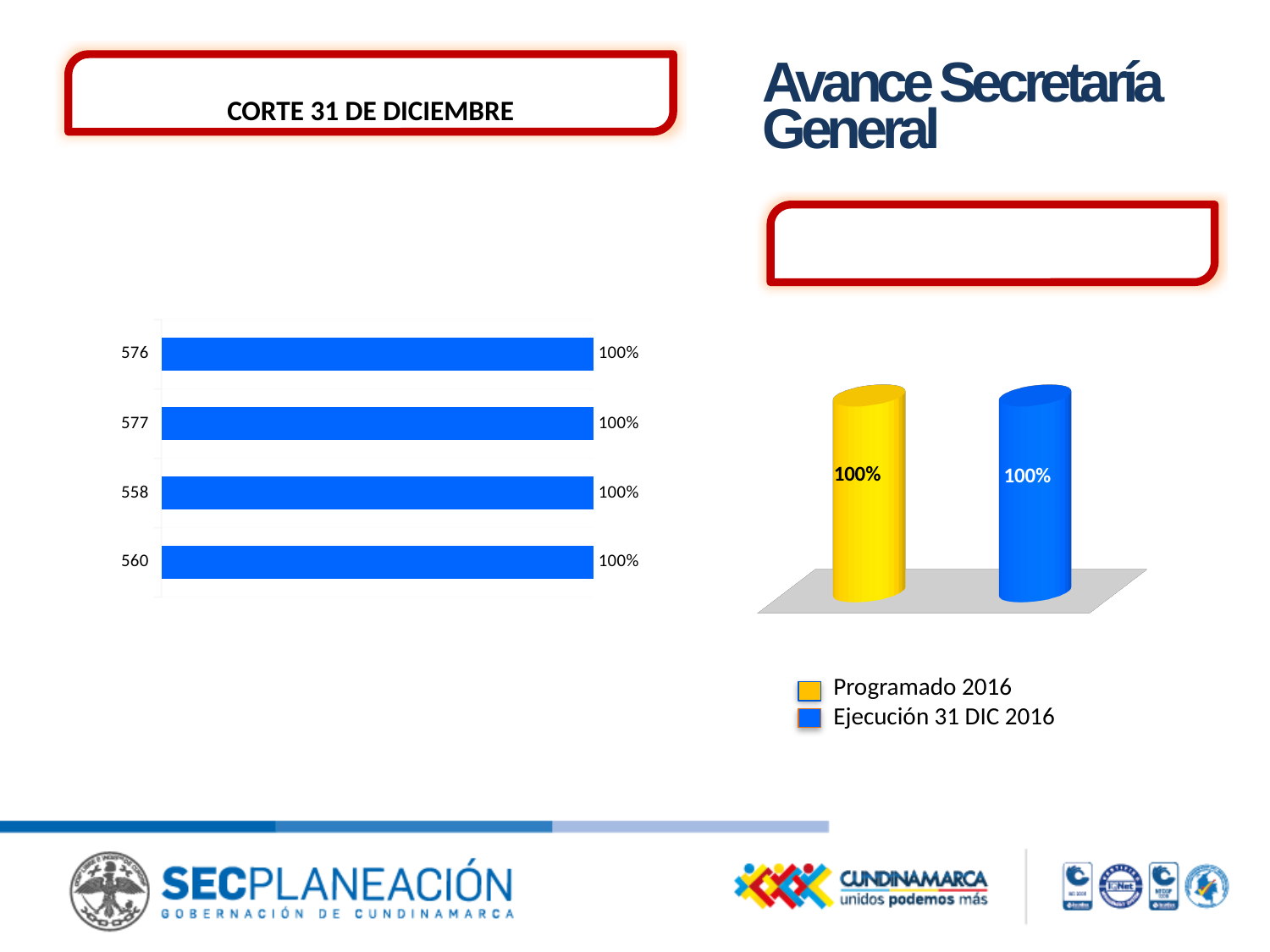
In the right chart, what is the difference between Programado 2016 and Ejecución 31 DIC 2016? 0% In the right chart, what is the value for Ejecución 31 DIC 2016? 100% In the right chart, what is the value for Programado 2016? 100% In the left bar chart, what is the value for category 560? 100% In the left bar chart, what is the value for category 577? 100% How many categories does the left bar chart show? 4 In the left bar chart, what is the value for category 558? 100% In the right chart, which colour represents Programado 2016? yellow In the left bar chart, what is the difference between the values for 576 and 560? 0% What kind of chart is the chart on the left of the slide? bar chart In the left bar chart, what is the value for category 576? 100% How many series does the legend of the right chart list? 2